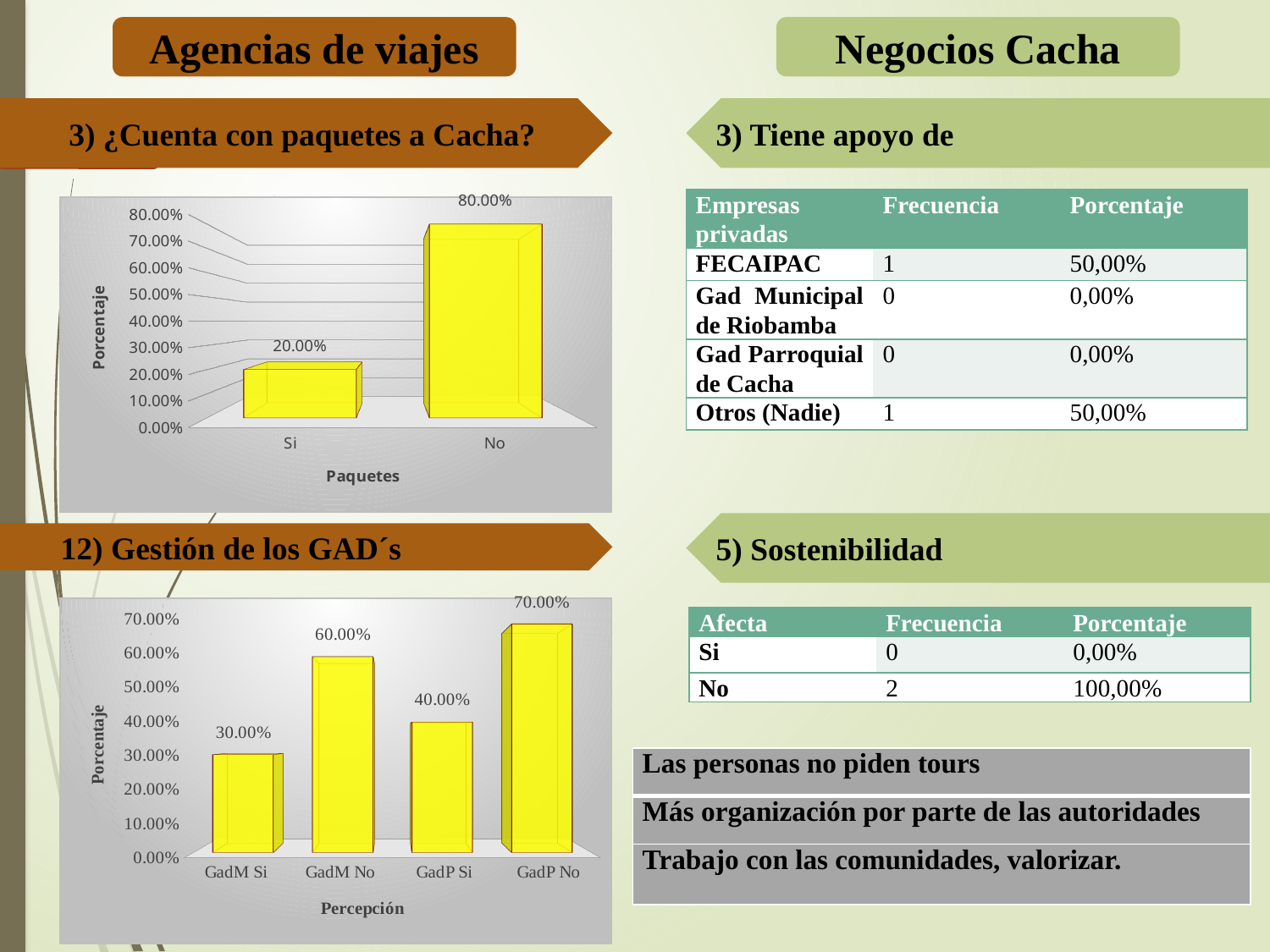
In the top-left chart (¿Cuenta con paquetes a Cacha?), how many categories are shown on the x axis? 2 In the bottom-left chart (Gestión de los GAD´s), how many categories are shown on the x axis? 4 In the bottom-left chart (Gestión de los GAD´s), which category has the highest value? GadP No In the top-left chart (¿Cuenta con paquetes a Cacha?), what is the x-axis title? Paquetes In the bottom-left chart (Gestión de los GAD´s), what is the difference between the values for "GadP No" and "GadM Si"? 40.00% In the bottom-left chart (Gestión de los GAD´s), which category has the lowest value? GadM Si In the top-left chart (¿Cuenta con paquetes a Cacha?), what is the value for "Si"? 20.00% In the bottom-left chart (Gestión de los GAD´s), what is the value for "GadP Si"? 40.00% In the top-left chart (¿Cuenta con paquetes a Cacha?), what is the value for "No"? 80.00% In the top-left chart (¿Cuenta con paquetes a Cacha?), what is the difference between the values for "No" and "Si"? 60.00% In the bottom-left chart (Gestión de los GAD´s), what is the value for "GadM No"? 60.00% What kind of chart is the top-left chart (¿Cuenta con paquetes a Cacha?)? Bar chart